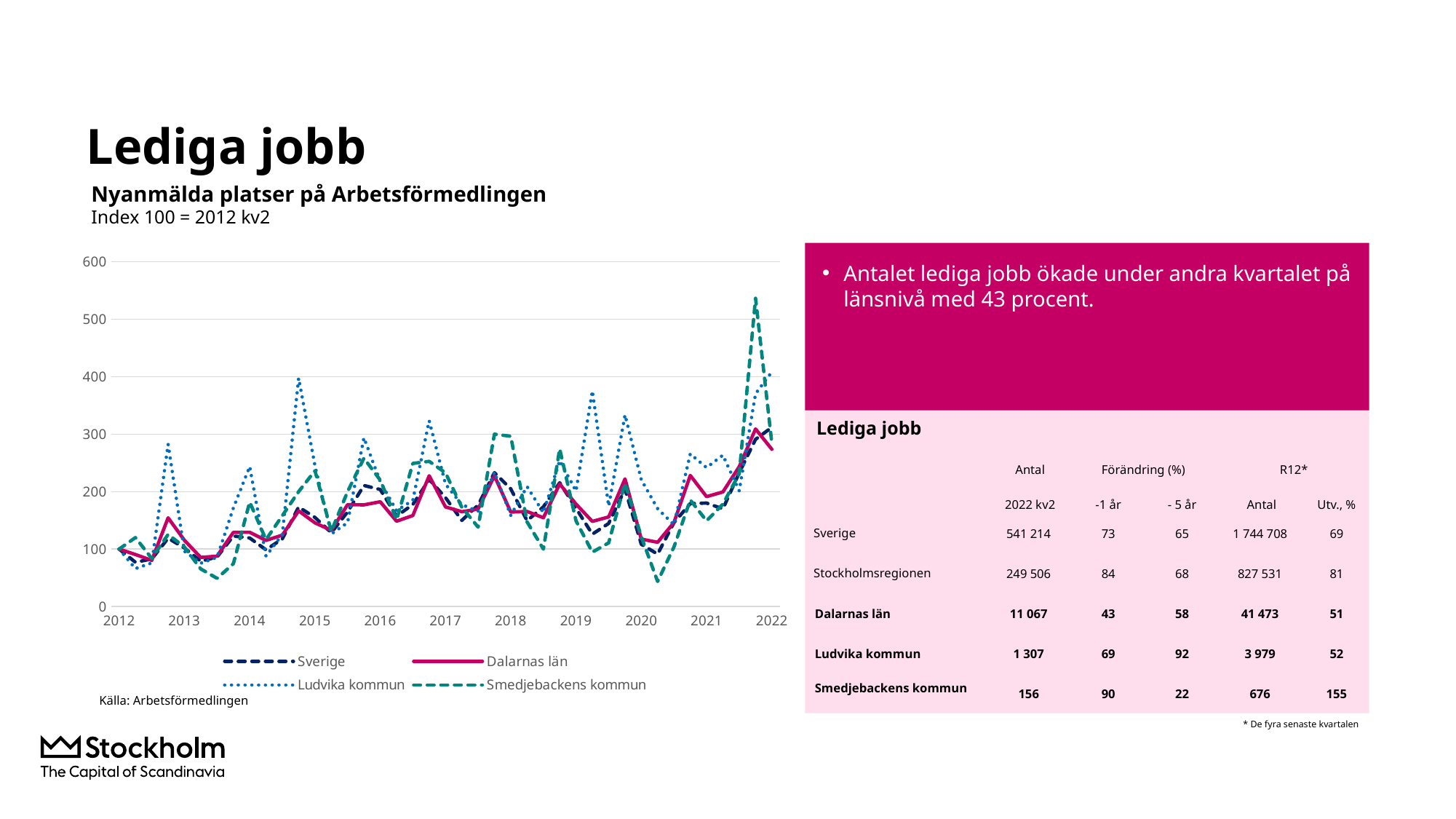
How many year labels are shown on the x axis? 11 Is the peak value for Ludvika kommun in 2019 greater or less than 300? greater What is the index value for all series at the starting point, 2012 kv2? 100 Does the Dalarnas län series rise or fall between 2020 and 2022? rise What is the title of the chart? Nyanmälda platser på Arbetsförmedlingen Is the peak value for Smedjebackens kommun in late 2021 greater or less than 500? greater What kind of chart is shown on the slide? line chart How many series does the chart legend list? 4 Which series reaches the highest peak on the chart? Smedjebackens kommun What source is cited below the chart? Arbetsförmedlingen Is the lowest value for Smedjebackens kommun in 2020 greater or less than 100? less